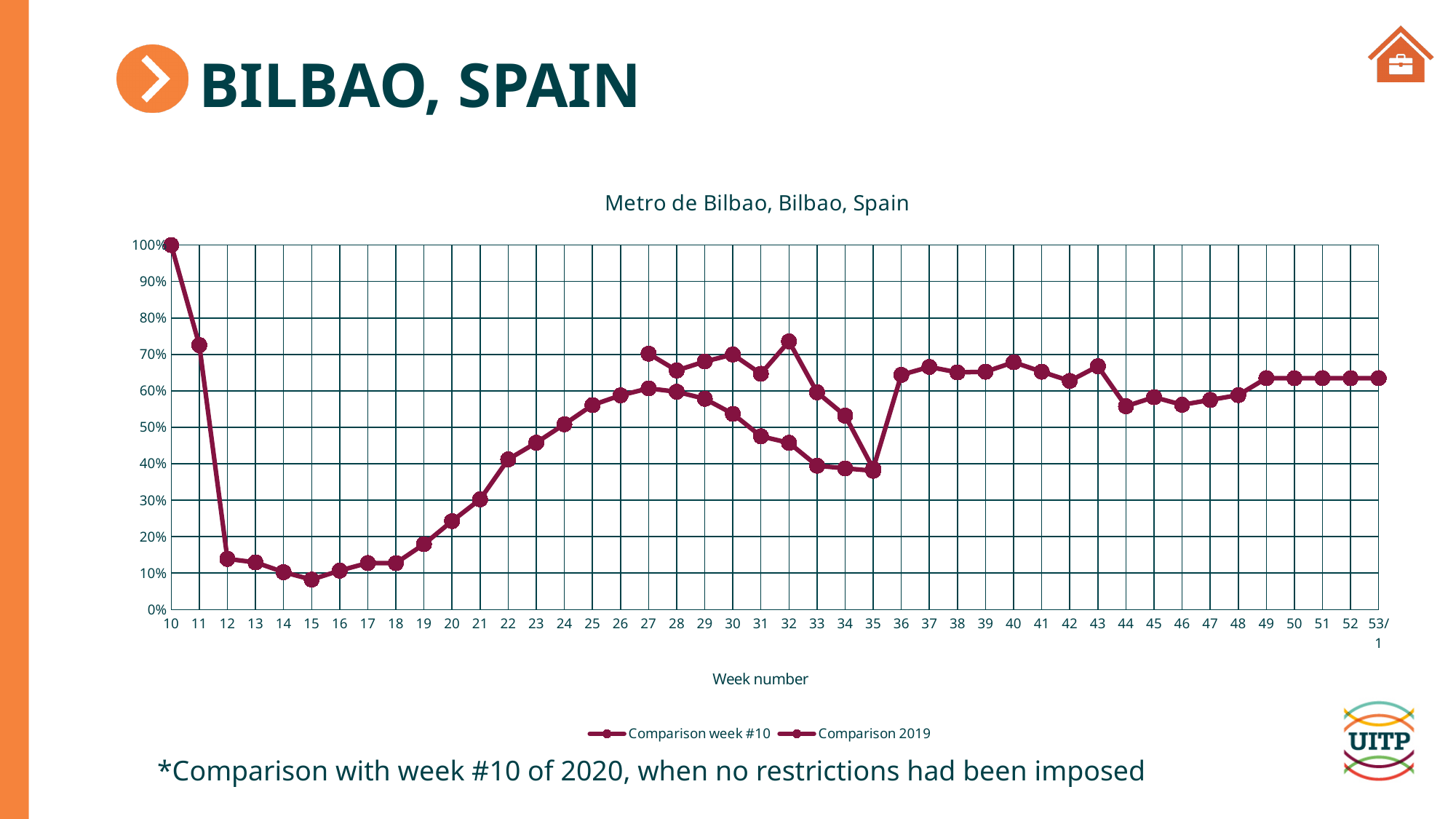
Do the values rise or fall from week 15 to week 27? rise Is the value for week 12 greater or less than 20%? less What kind of chart is shown on the slide? line chart Which week has the highest value? 10 Is the value for week 44 greater or less than 60%? less What is the value at week 10? 100% Is the value for week 11 greater or less than 70%? greater What are the two series named in the legend? Comparison week #10 and Comparison 2019 How many series does the legend list? 2 Which week has the lowest value? 15 What is the title of the chart? Metro de Bilbao, Bilbao, Spain Which is larger, the value for week 11 or the value for week 12? week 11